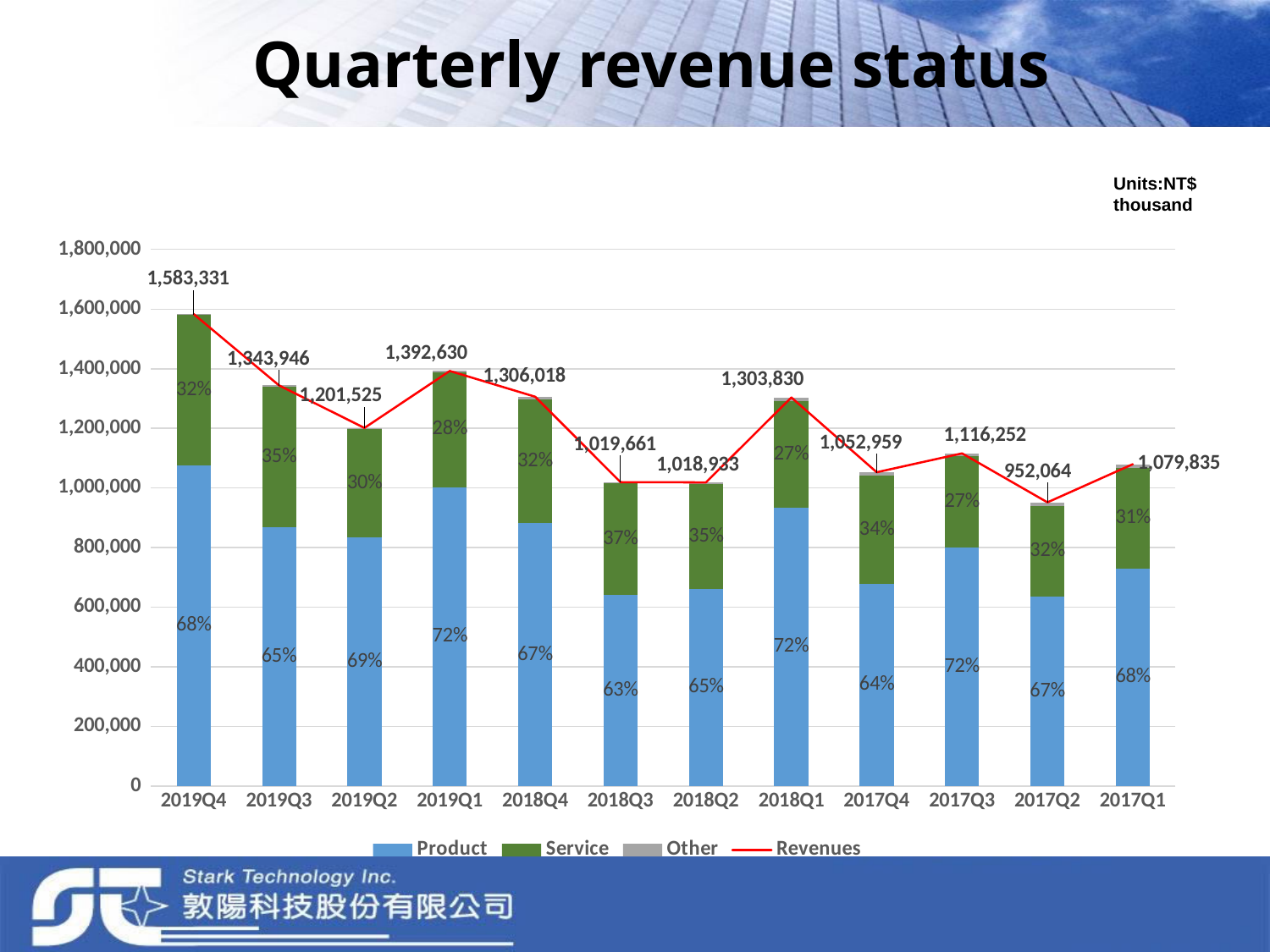
Is the Product value for 2019Q4 greater or less than 1,000,000? greater How many quarters are shown on the x axis? 12 Which quarter has the lowest Revenues? 2017Q2 How many series does the legend list? 4 What percentage share does Product have in 2018Q3? 63% What is the Revenues value for 2017Q2? 952,064 What percentage share does Service have in 2019Q1? 28% What is the Revenues value for 2019Q4? 1,583,331 Which quarter has higher Revenues, 2019Q1 or 2018Q4? 2019Q1 Which quarter has the highest Revenues? 2019Q4 What unit is stated for the values in the chart? NT$ thousand What is the difference in Revenues between 2019Q4 and 2019Q3? 239,385